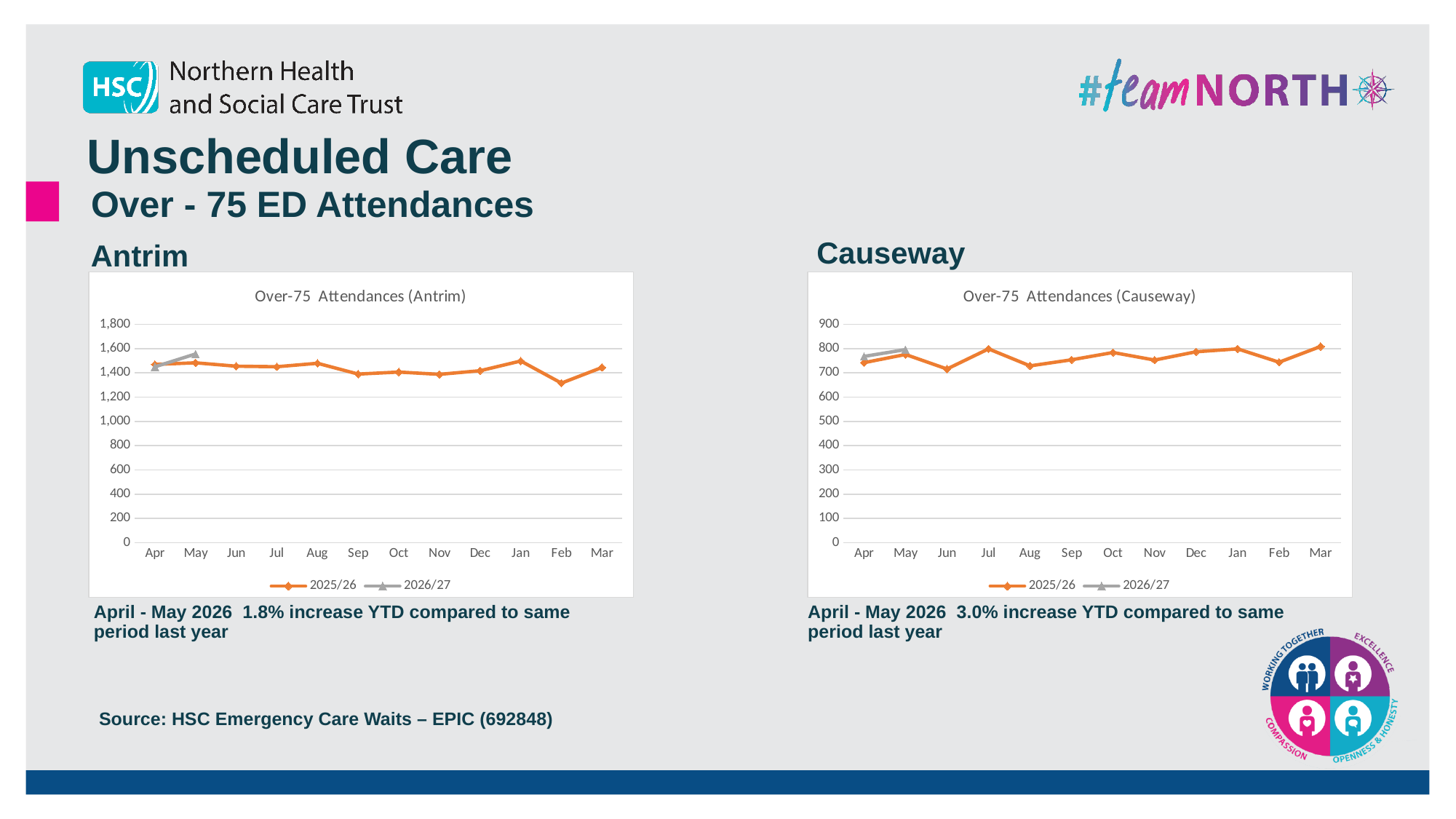
In the Over-75 Attendances (Antrim) chart, is the 2025/26 value for Feb greater or less than 1,400? less In the Over-75 Attendances (Causeway) chart, is the 2025/26 value for Jun greater or less than 800? less What kind of chart is the Over-75 Attendances (Antrim) chart? line chart In the Over-75 Attendances (Causeway) chart, is the 2025/26 value for Mar greater or less than 700? greater In the Over-75 Attendances (Causeway) chart, which is larger for 2025/26: Jan or Feb? Jan In the Over-75 Attendances (Causeway) chart, which is larger for 2025/26: Jun or Jul? Jul How many series does the legend of the Over-75 Attendances (Causeway) chart list? 2 What are the two series named in the legend of the Over-75 Attendances (Antrim) chart? 2025/26 and 2026/27 In the Over-75 Attendances (Antrim) chart, which month has the lowest 2025/26 value? Feb How many months are shown on the x axis of the Over-75 Attendances (Antrim) chart? 12